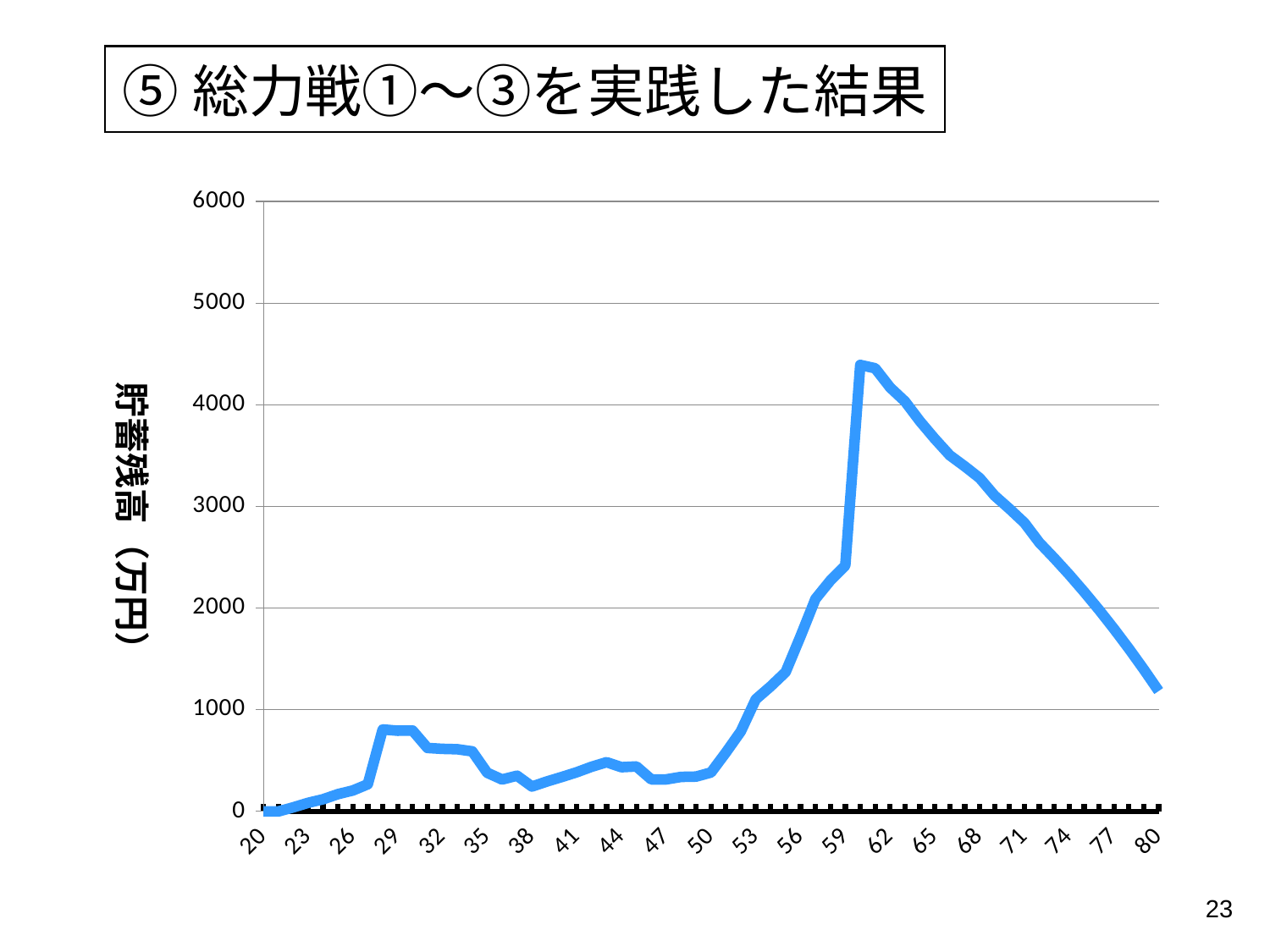
Is the value at age 80 greater or less than 1000? greater Is the value at age 65 greater or less than 3000? greater What is the highest value shown on the vertical axis? 6000 What kind of chart is shown on the slide? line chart Does the line rise or fall between age 62 and age 80? fall Is the value at age 29 greater or less than 1000? less At which age on the x axis is the value lowest? 20 What is the label of the vertical axis? 貯蓄残高（万円） Which is larger, the value at age 65 or the value at age 74? age 65